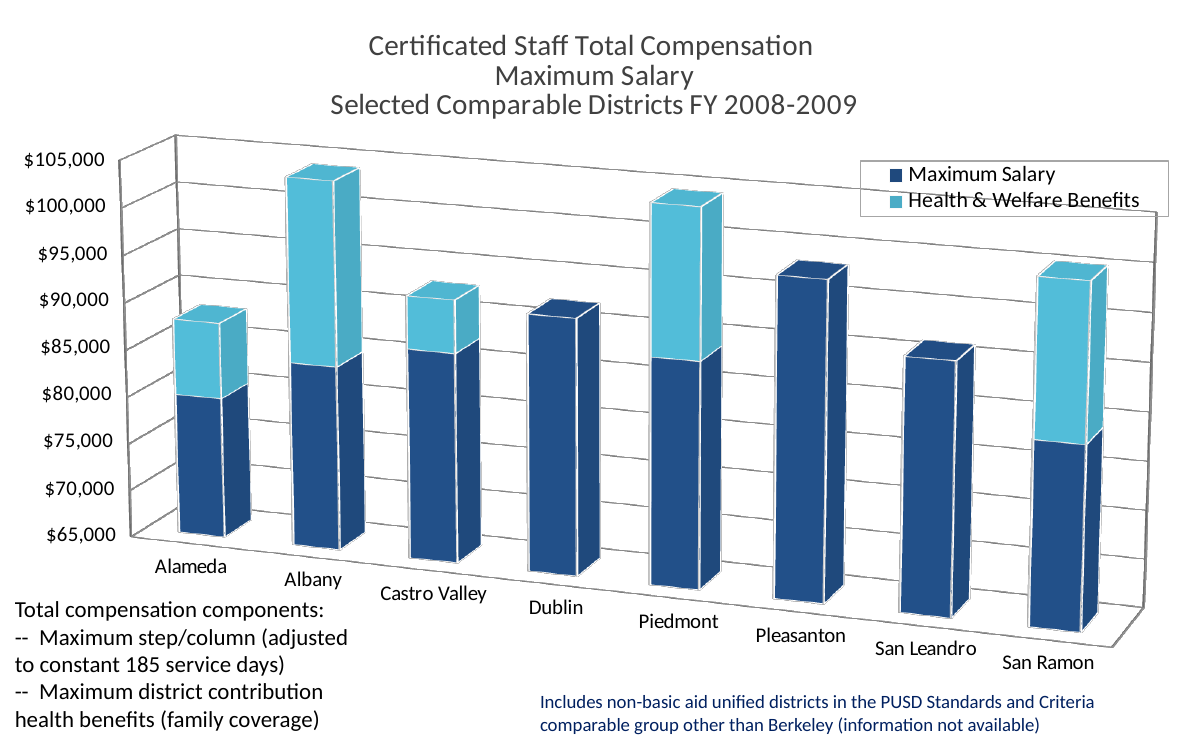
What type of chart is shown on the slide? Stacked bar chart Which district has the lowest total compensation bar? Alameda Is the total compensation bar for Albany greater or less than $95,000? greater How many districts are shown on the x axis of the chart? 8 Which district has the lowest Maximum Salary segment? Alameda Which is larger, the total compensation bar for Albany or for Castro Valley? Albany How many series does the chart legend list? 2 How many districts show no Health & Welfare Benefits segment? 3 Which district has the highest Maximum Salary segment? Pleasanton